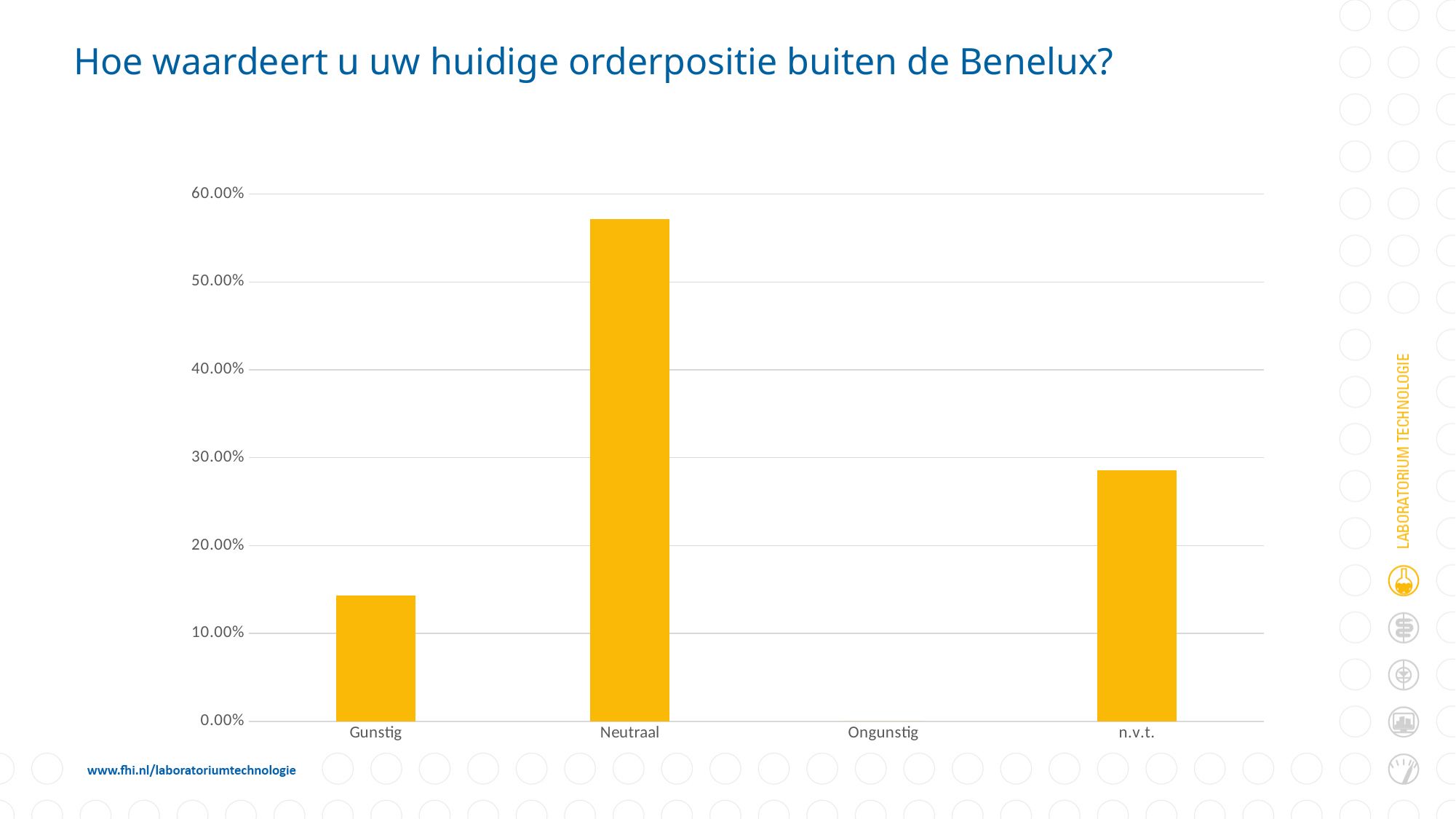
Which category has the lowest value in the chart? Ongunstig Is the value for Gunstig greater or less than 20.00%? less Which category has the highest value in the chart? Neutraal What is the title of the slide containing the chart? Hoe waardeert u uw huidige orderpositie buiten de Benelux? Which is larger, the value for Neutraal or the value for n.v.t.? Neutraal Is the value for n.v.t. greater or less than 20.00%? greater Is the value for Neutraal greater or less than 50.00%? greater Which is larger, the value for Gunstig or the value for n.v.t.? n.v.t. What colour are the bars in the chart? yellow How many categories are shown on the x axis of the chart? 4 What type of chart is shown on the slide? bar chart